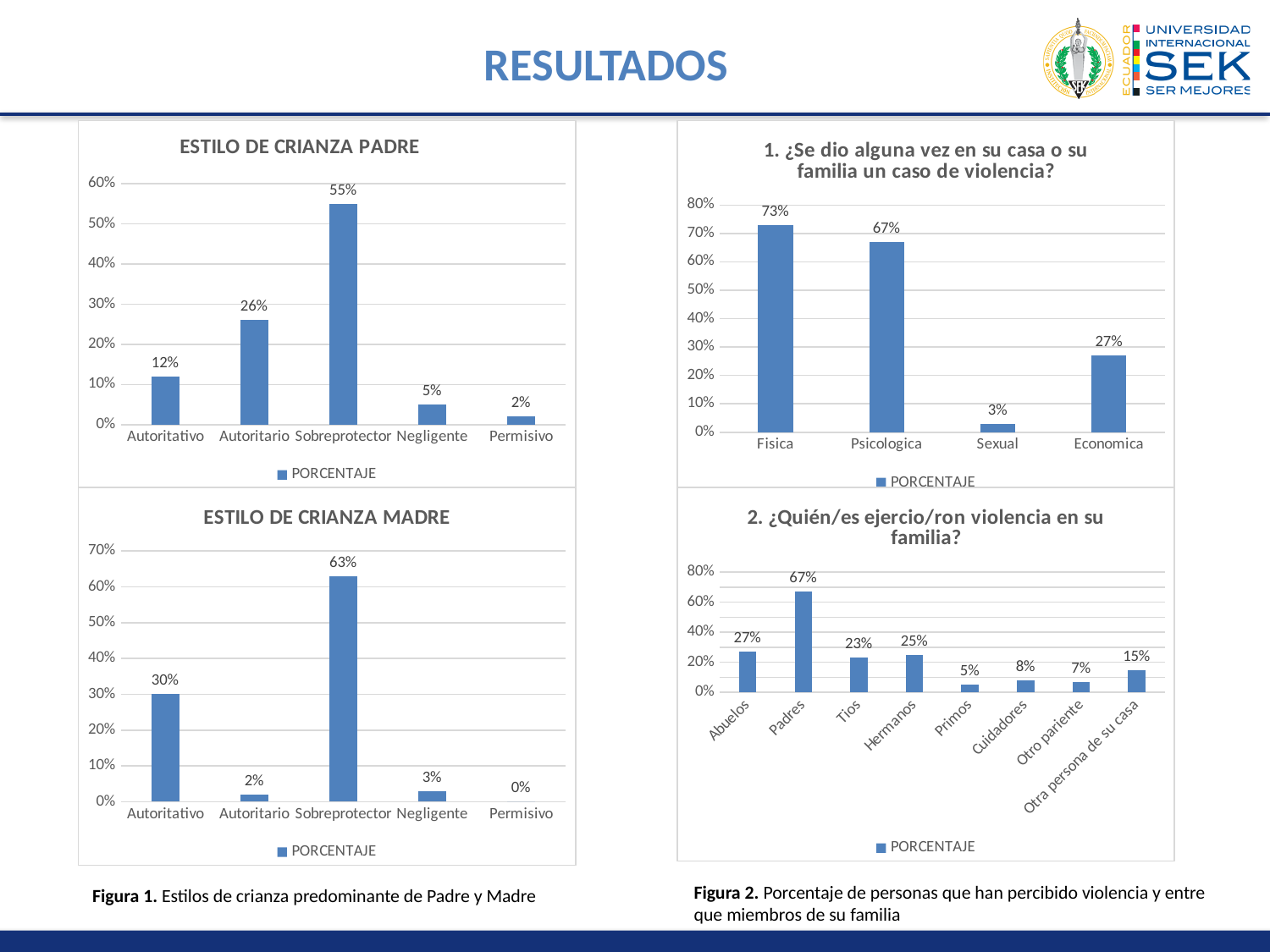
In the chart titled '1. ¿Se dio alguna vez en su casa o su familia un caso de violencia?', which category has the highest value? Fisica In the chart titled '1. ¿Se dio alguna vez en su casa o su familia un caso de violencia?', which is larger, Sexual or Economica? Economica In the chart titled '2. ¿Quién/es ejercio/ron violencia en su familia?', what is the value for Hermanos? 25% In the 'ESTILO DE CRIANZA PADRE' chart, what is the value for Sobreprotector? 55% In the 'ESTILO DE CRIANZA PADRE' chart, which category has the lowest value? Permisivo In the chart titled '1. ¿Se dio alguna vez en su casa o su familia un caso de violencia?', what is the value for Psicologica? 67% In the chart titled '2. ¿Quién/es ejercio/ron violencia en su familia?', which category has the lowest value? Primos In the 'ESTILO DE CRIANZA MADRE' chart, what is the difference between Sobreprotector and Autoritativo? 33% In the 'ESTILO DE CRIANZA MADRE' chart, what is the value for Autoritativo? 30% In the 'ESTILO DE CRIANZA MADRE' chart, how many categories are shown on the x axis? 5 In the chart titled '2. ¿Quién/es ejercio/ron violencia en su familia?', how many categories are shown on the x axis? 8 What kind of chart is the 'ESTILO DE CRIANZA PADRE' chart? Bar chart